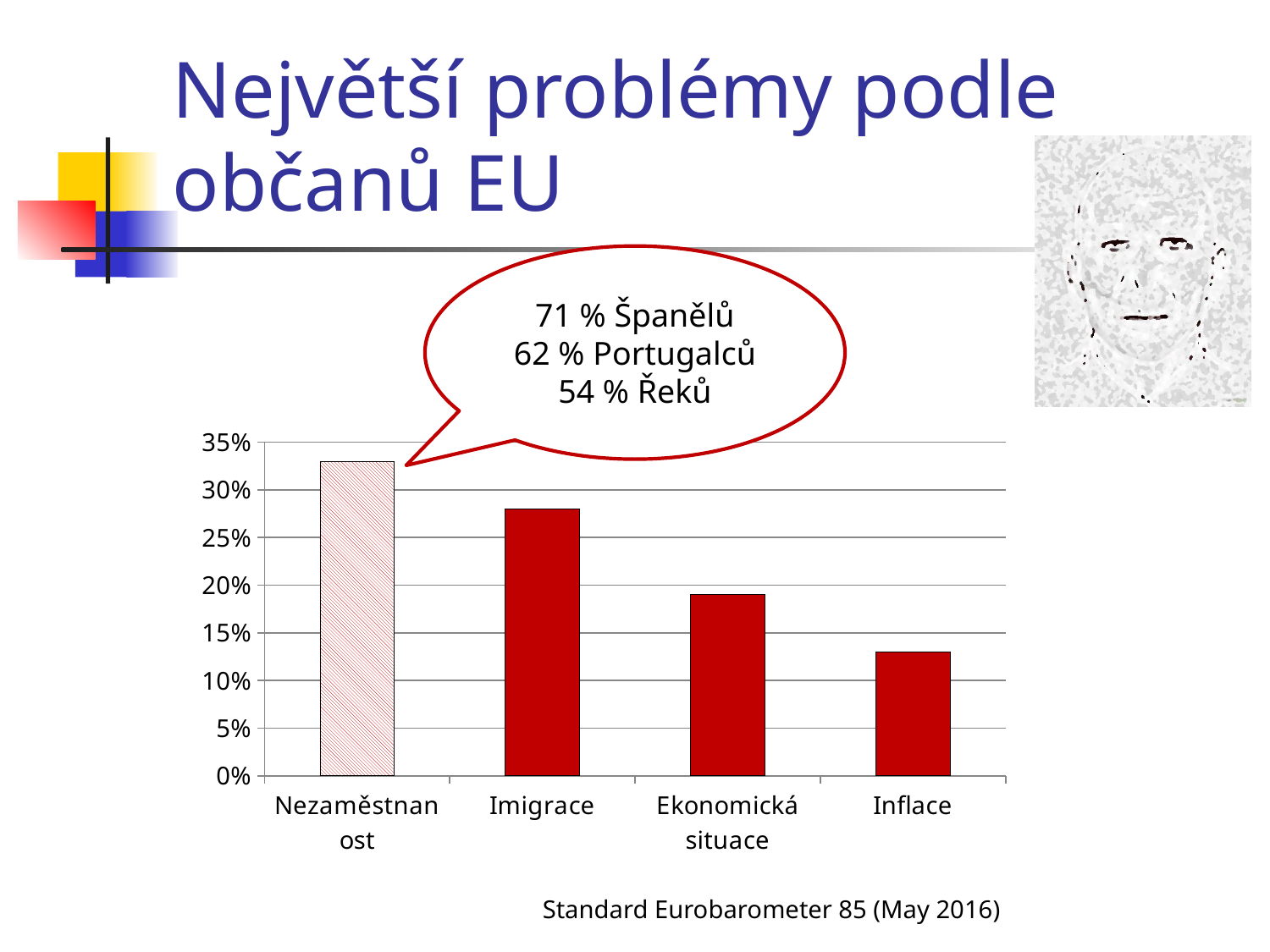
Is the value for Nezaměstnanost greater or less than 30%? greater What kind of chart is shown on the slide? bar chart Which category has the lowest value in the chart? Inflace Which is larger, the value for Inflace or the value for Nezaměstnanost? Nezaměstnanost Do the bar values rise or fall from left to right across the x axis? fall How many categories are shown on the x axis of the chart? 4 What is the title of the slide containing the chart? Největší problémy podle občanů EU Is the value for Inflace greater or less than 15%? less Which is larger, the value for Imigrace or the value for Ekonomická situace? Imigrace Is the value for Ekonomická situace greater or less than 15%? greater Which category has the highest value in the chart? Nezaměstnanost